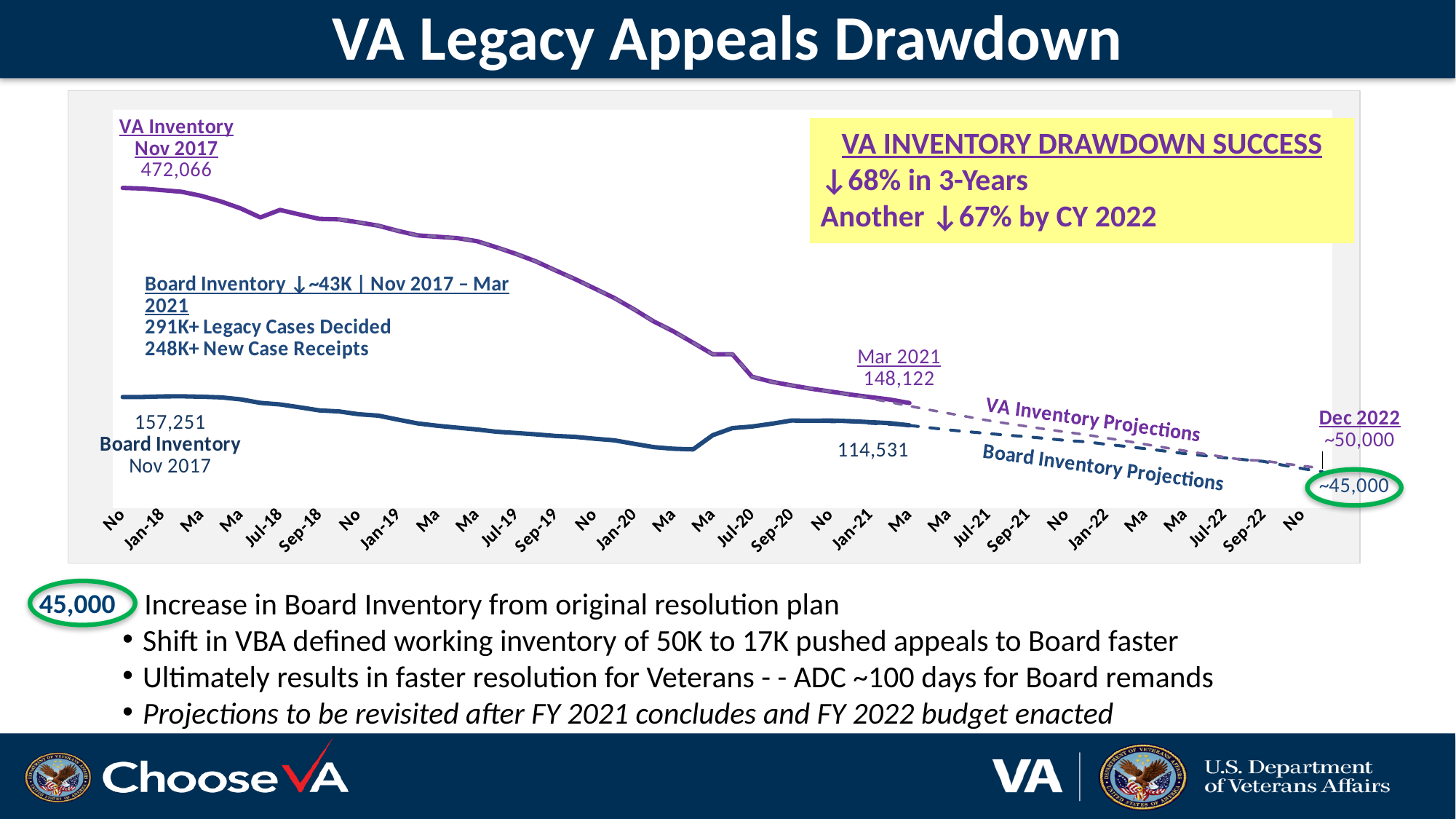
What colour is the VA Inventory line on the chart? Purple By how much did the Board Inventory fall from Nov 2017 to Mar 2021? 42,720 In Nov 2017, which was larger, the VA Inventory or the Board Inventory? VA Inventory What was the VA Inventory in Nov 2017? 472,066 By how much did the VA Inventory fall from Nov 2017 to Mar 2021? 323,944 What was the Board Inventory in Nov 2017? 157,251 What was the Board Inventory in Mar 2021? 114,531 Does the VA Inventory line rise or fall from Nov 2017 to Mar 2021? Fall What is the difference between the VA Inventory and the Board Inventory in Mar 2021? 33,591 According to the highlighted box, by what percentage did VA Inventory drop in 3 years? 68% What kind of chart is shown on the slide? Line chart What was the VA Inventory in Mar 2021? 148,122